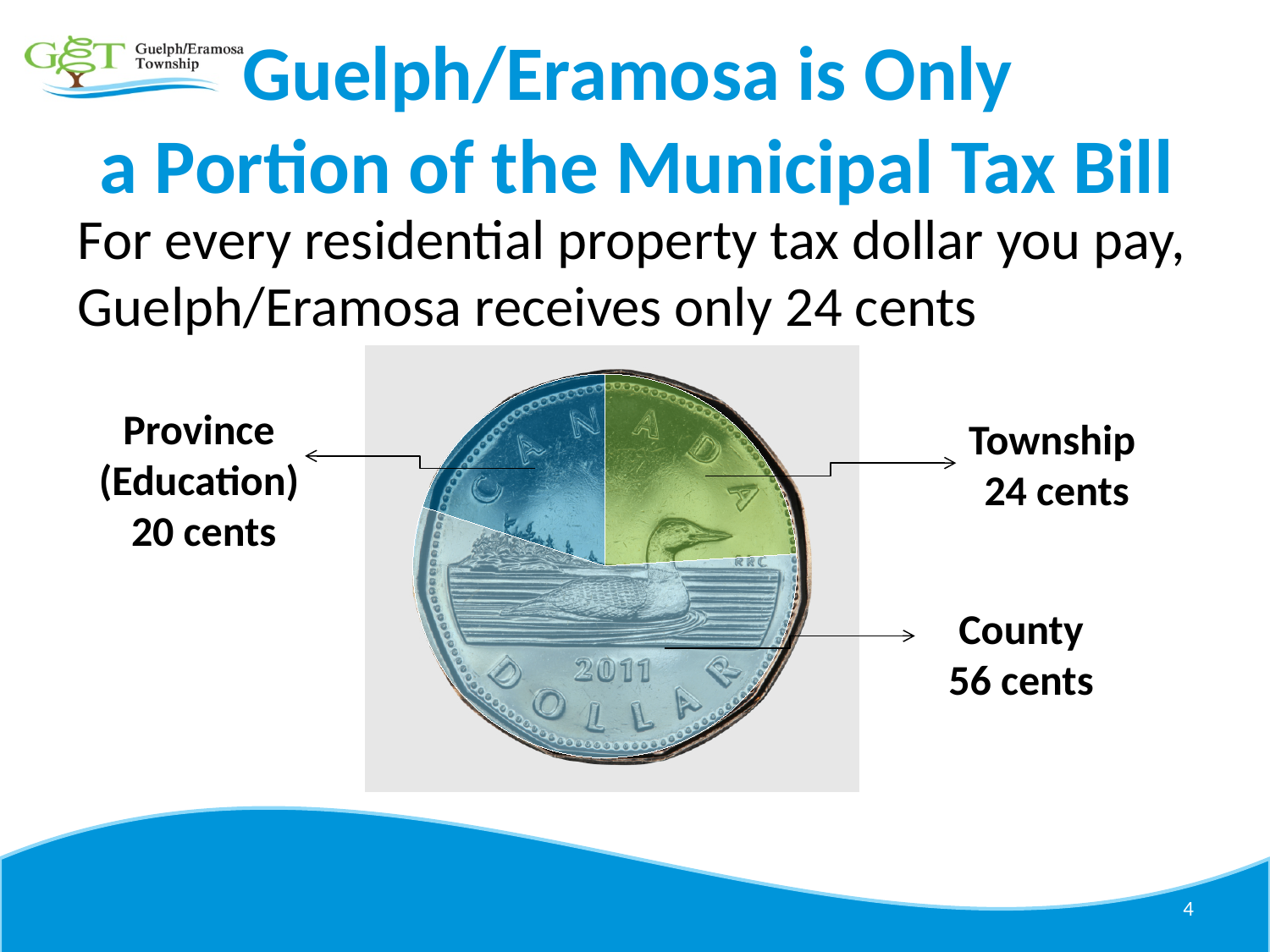
Which receives more of the tax dollar, the Township or the County? County How many cents of each residential property tax dollar go to the County? 56 cents How many cents of each residential property tax dollar does the Township receive? 24 cents Which recipient receives the smallest share of the residential property tax dollar? Province (Education) How many more cents does the Township receive than the Province (Education)? 4 cents Which recipient receives the largest share of the residential property tax dollar? County What colour is the Township segment of the chart? Green How many segments is the tax dollar divided into on the chart? 3 How many cents of each residential property tax dollar go to the Province (Education)? 20 cents How many more cents does the County receive than the Township? 32 cents What kind of chart is used to show the split of the tax dollar? Pie chart What is the total of the three segments shown on the chart? 100 cents